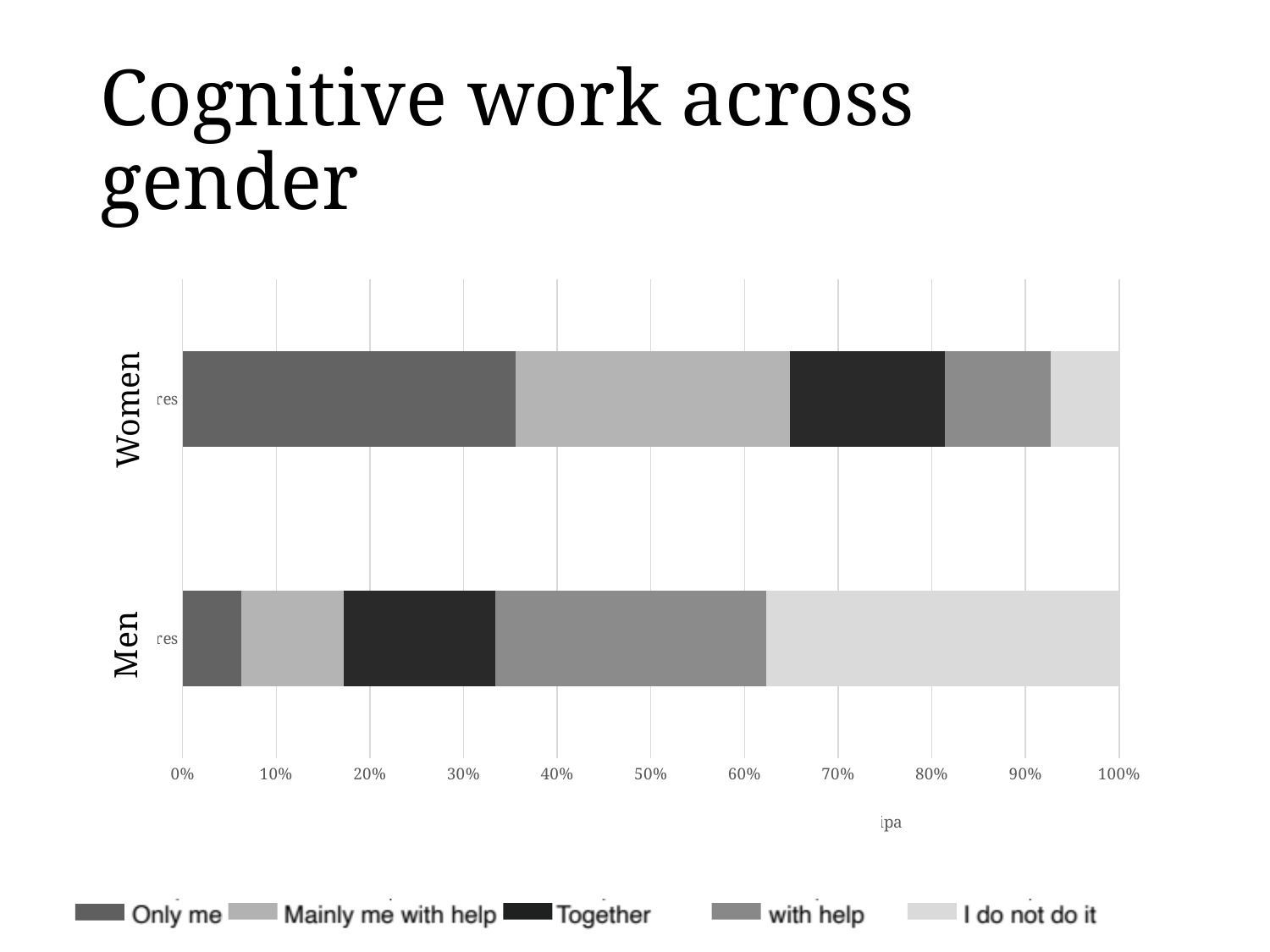
How many categories (groups) are plotted on the chart? 2 Which legend entry is shown in the darkest (near-black) colour? Together Is the value for 'I do not do it' in the Men bar greater or less than 30%? greater Which group has the larger 'I do not do it' share, Women or Men? Men Which group has the larger 'Mainly me with help' share, Women or Men? Women Is the value for 'Only me' in the Men bar greater or less than 10%? less What is the title of the slide? Cognitive work across gender How many series does the legend list? 5 Which group has the larger 'Only me' share, Women or Men? Women Is the value for 'Only me' in the Women bar greater or less than 30%? greater What kind of chart is shown on the slide? stacked bar chart